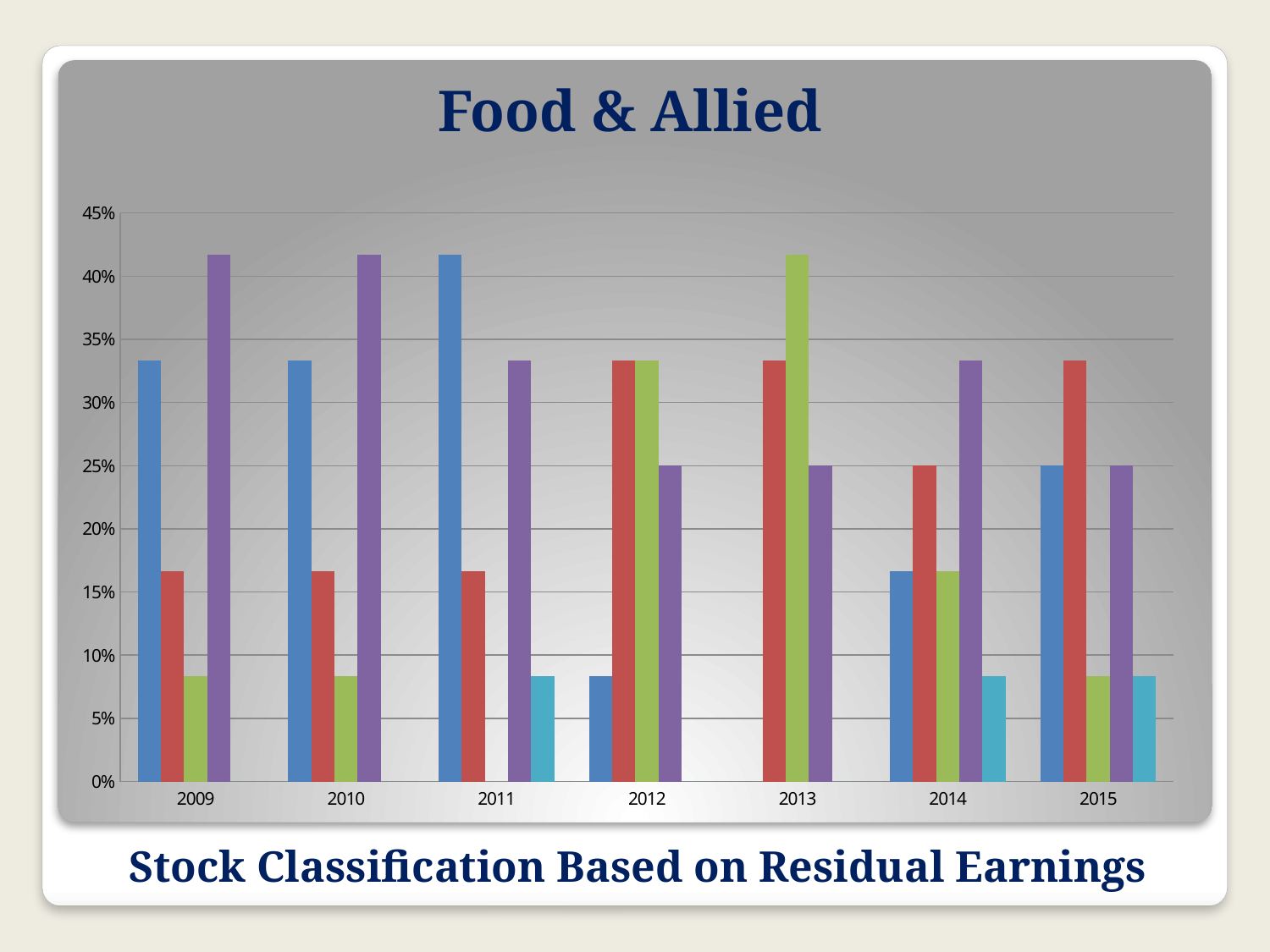
Is the value of the green bar for 2013 greater or less than 40%? greater What is the title of the chart? Food & Allied How many years are shown on the x axis of the chart? 7 What kind of chart is shown on the slide? bar chart What is the value of the purple bar for 2015? 25% For 2014, which is larger: the purple bar or the blue bar? purple What is the value of the red bar for 2014? 25% Which coloured bar is the tallest for 2011? blue Is the value of the blue bar for 2012 greater or less than 10%? less Is the value of the purple bar for 2009 greater or less than 40%? greater Which coloured bar is the shortest for 2009? green What is the value of the blue bar for 2015? 25%